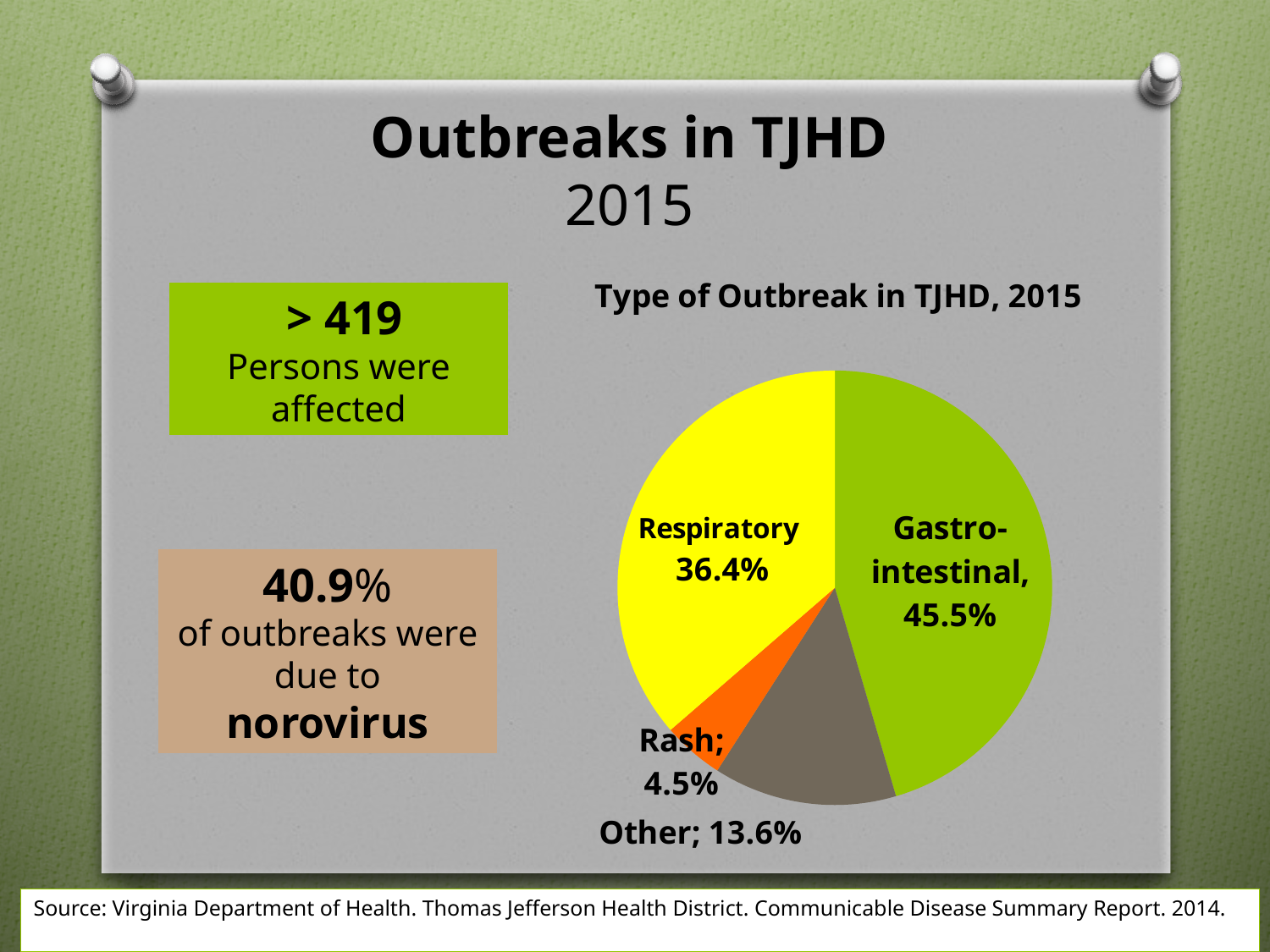
What share of outbreaks is Respiratory? 36.4% Which type of outbreak has the smallest share? Rash Which is larger, the share for Other or the share for Rash? Other What is the difference in percentage points between Gastro-intestinal and Respiratory? 9.1 What is the title of the chart? Type of Outbreak in TJHD, 2015 What share of outbreaks is Other? 13.6% What share of outbreaks is Gastro-intestinal? 45.5% What colour is the Respiratory slice? yellow How many slices does the pie chart have? 4 What type of chart is shown on the slide? pie chart Which type of outbreak has the largest share? Gastro-intestinal What share of outbreaks is Rash? 4.5%